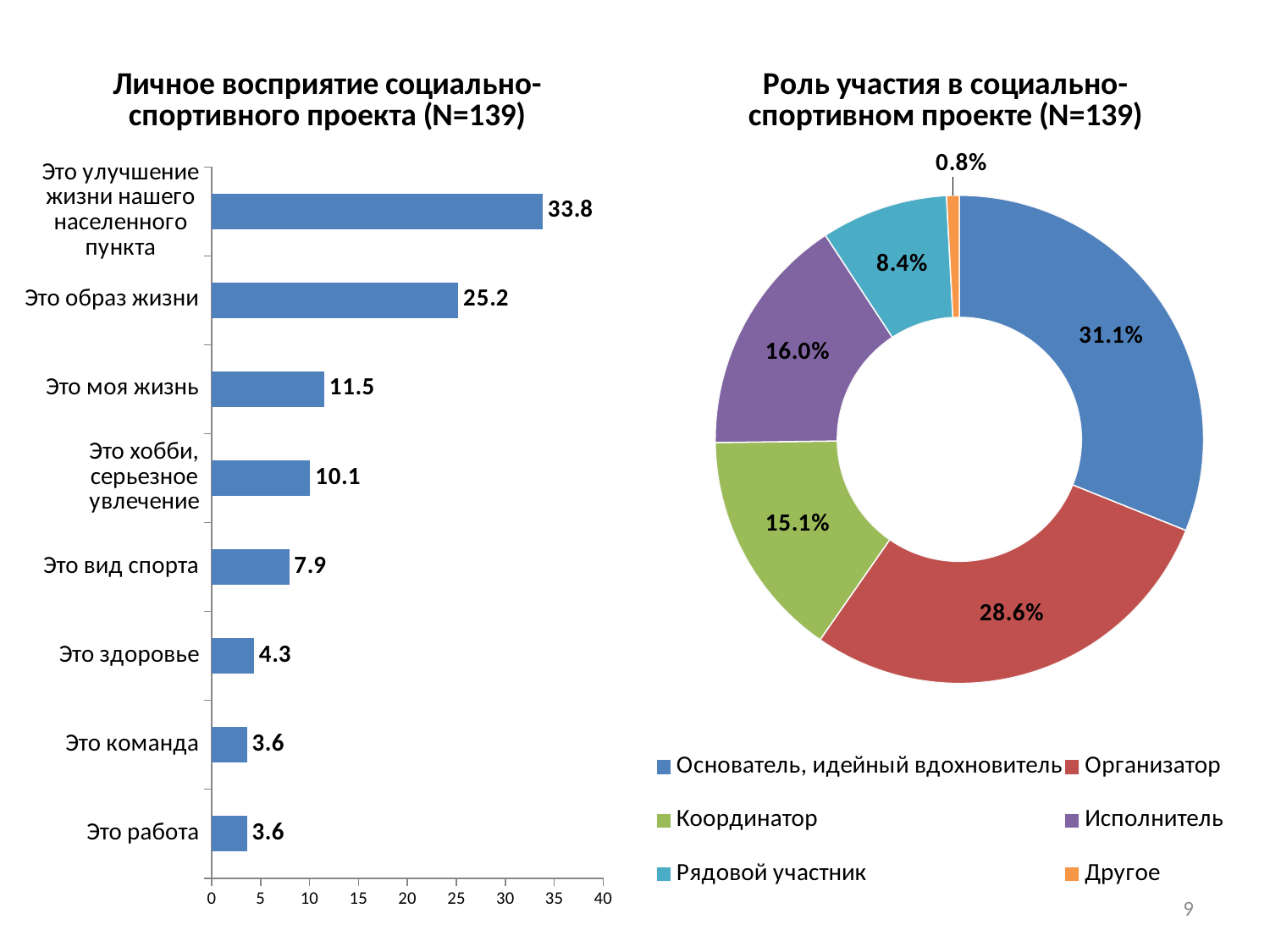
In the chart 'Личное восприятие социально-спортивного проекта (N=139)', what is the difference between 'Это моя жизнь' and 'Это хобби, серьезное увлечение'? 1.4 How many categories are shown in the chart 'Личное восприятие социально-спортивного проекта (N=139)'? 8 In the chart 'Личное восприятие социально-спортивного проекта (N=139)', which is larger: 'Это здоровье' or 'Это команда'? Это здоровье In the chart 'Личное восприятие социально-спортивного проекта (N=139)', what is the value for 'Это вид спорта'? 7.9 In the chart 'Роль участия в социально-спортивном проекте (N=139)', what share is 'Исполнитель'? 16.0% In the chart 'Роль участия в социально-спортивном проекте (N=139)', which role has the smallest share? Другое In the chart 'Личное восприятие социально-спортивного проекта (N=139)', what is the value for 'Это образ жизни'? 25.2 What type of chart is 'Личное восприятие социально-спортивного проекта (N=139)'? Bar chart How many entries does the legend of the chart 'Роль участия в социально-спортивном проекте (N=139)' list? 6 In the chart 'Личное восприятие социально-спортивного проекта (N=139)', which category has the highest value? Это улучшение жизни нашего населенного пункта In the chart 'Роль участия в социально-спортивном проекте (N=139)', what is the difference between 'Основатель, идейный вдохновитель' and 'Рядовой участник'? 22.7% In the chart 'Роль участия в социально-спортивном проекте (N=139)', what share is 'Организатор'? 28.6%